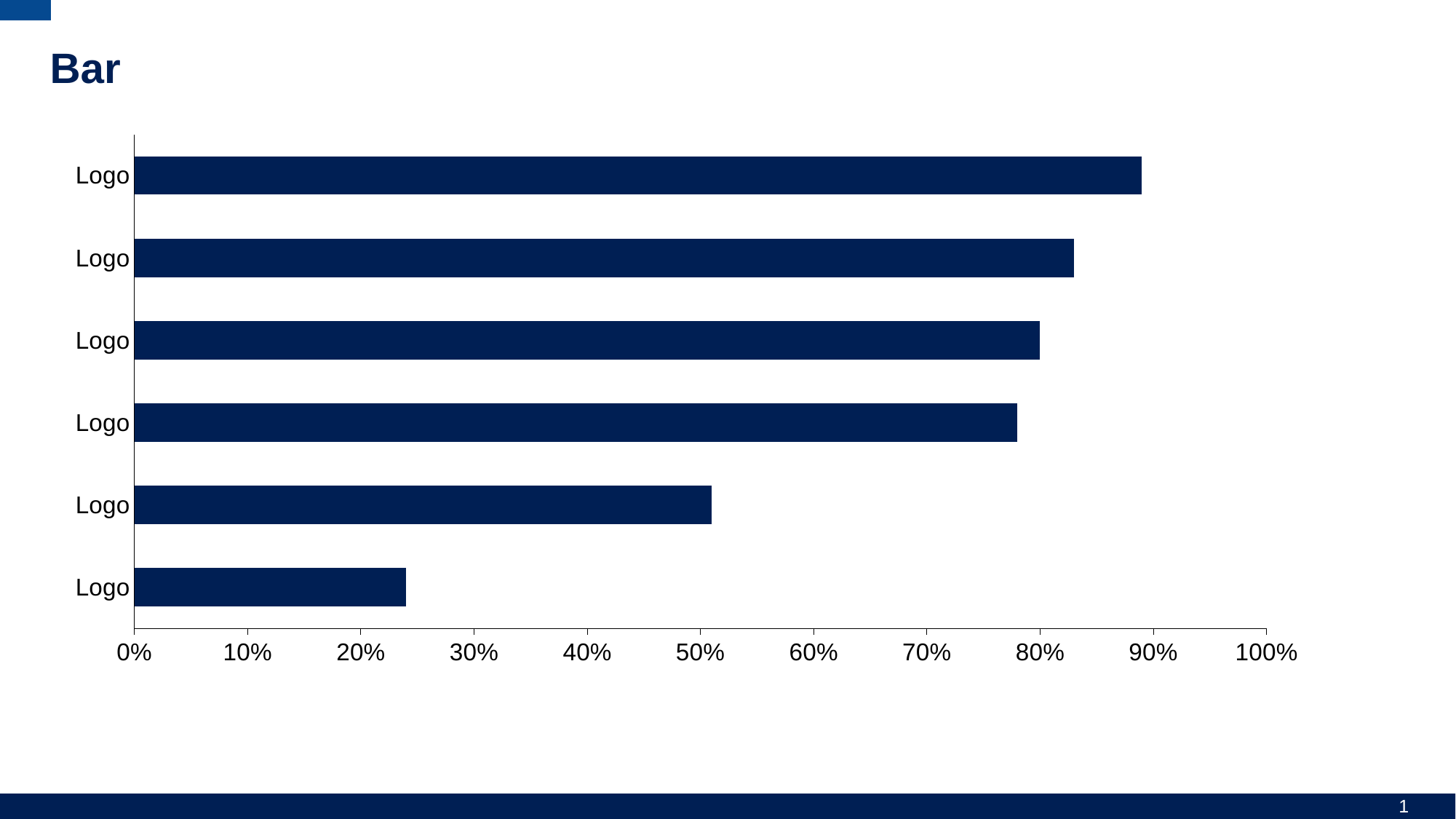
Which bar is the shortest? the bottom bar How many bars does the chart have? 6 What is the title of the slide? Bar Which bar is the longest? the top bar What kind of chart is shown on the slide? bar chart Do the bar values increase or decrease going from the top bar to the bottom bar? decrease Is the value for the second bar from the top greater or less than 70%? greater What is the highest value shown on the horizontal axis? 100% Is the value for the top bar greater or less than 80%? greater Which is larger, the value of the top bar or the value of the bottom bar? the top bar Is the value for the fifth bar from the top greater or less than 60%? less